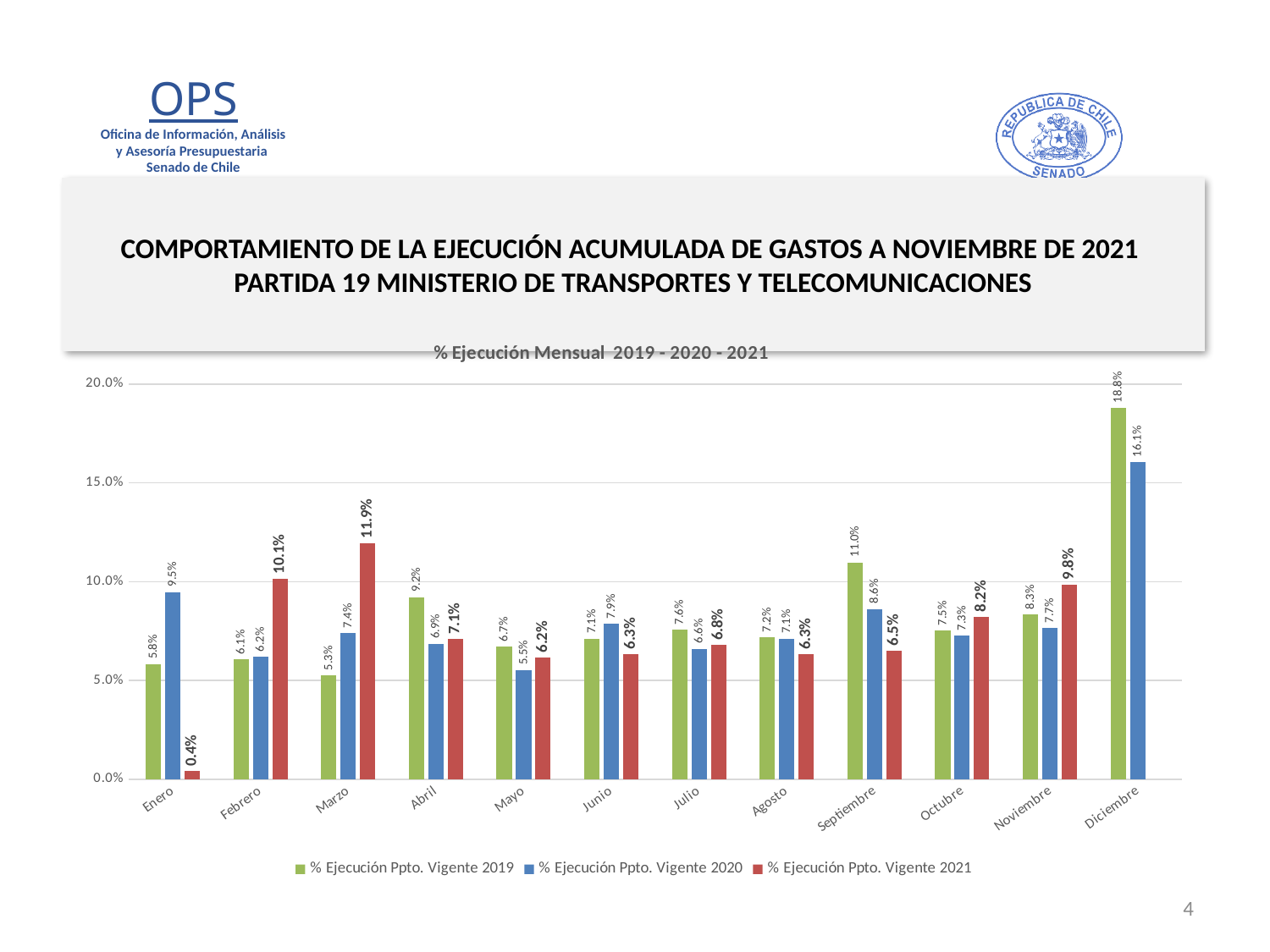
What is the value for % Ejecución Ppto. Vigente 2019 in Septiembre? 11.0% What is the value for % Ejecución Ppto. Vigente 2020 in Enero? 9.5% How many months are shown on the x axis? 12 What is the value for % Ejecución Ppto. Vigente 2021 in Marzo? 11.9% Is the value for % Ejecución Ppto. Vigente 2019 in Diciembre greater or less than 15.0%? greater What is the difference between the 2019 and 2020 values in Diciembre? 2.7% What is the value for % Ejecución Ppto. Vigente 2021 in Noviembre? 9.8% Which month has the lowest value for % Ejecución Ppto. Vigente 2021? Enero Which month has the highest value for % Ejecución Ppto. Vigente 2019? Diciembre How many series does the legend list? 3 Which is larger in Abril: the 2019 value or the 2020 value? 2019 (9.2%) What kind of chart is shown? Bar chart